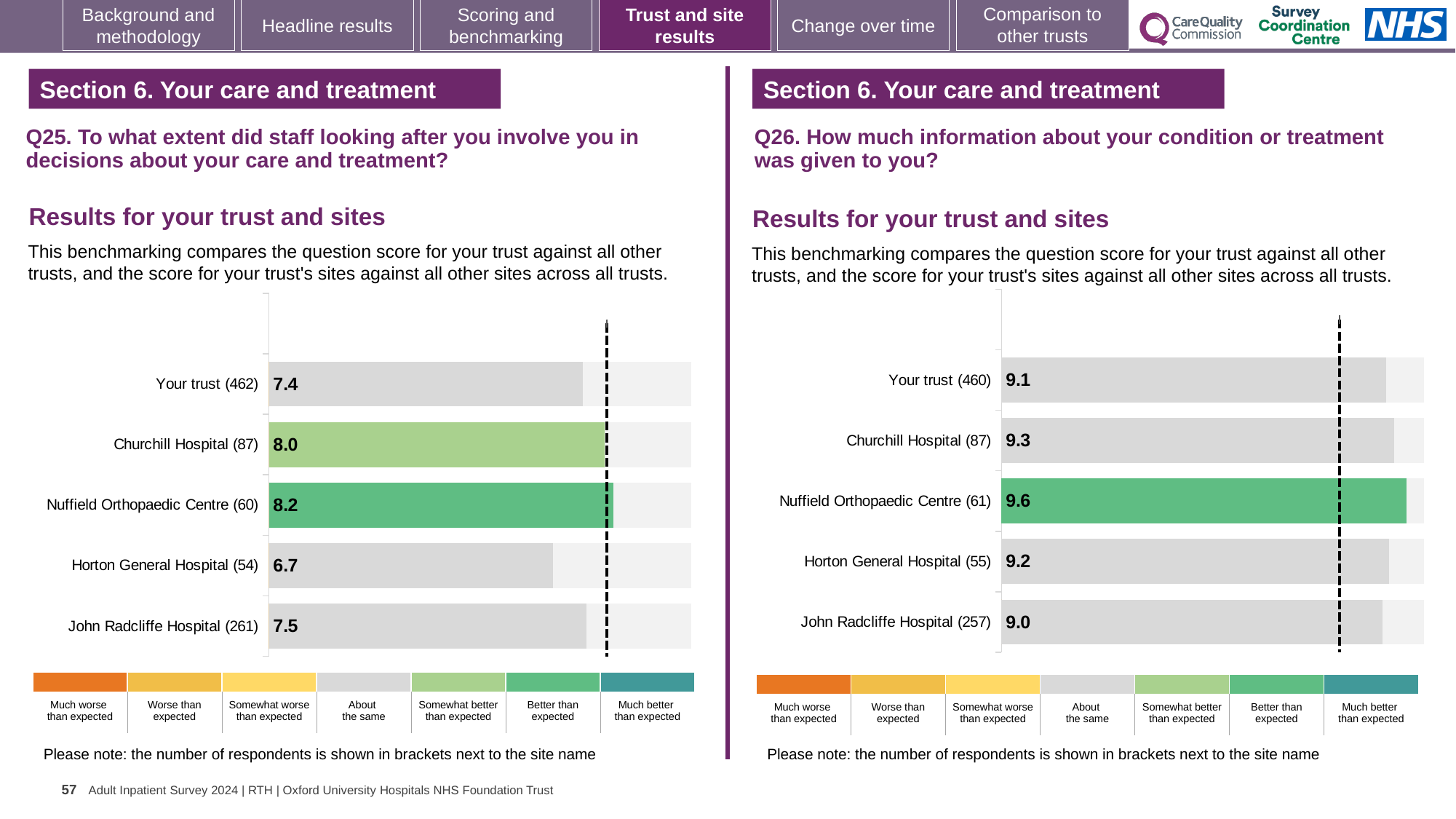
On the Q25 chart (left), what is the difference between the scores for Churchill Hospital and Horton General Hospital? 1.3 On the Q26 chart (right), what is the score for John Radcliffe Hospital? 9.0 On the Q25 chart (left), how many bars are plotted? 5 On the Q26 chart (right), which site has the highest score? Nuffield Orthopaedic Centre On the Q26 chart (right), what is the difference between the scores for Nuffield Orthopaedic Centre and Your trust? 0.5 On the Q25 chart (left), what is the score for Your trust? 7.4 On the Q25 chart (left), which benchmark category does the colour of the Nuffield Orthopaedic Centre bar correspond to in the legend? Better than expected What kind of chart is used on the Q26 chart (right)? Bar chart On the Q25 chart (left), which site has the lowest score? Horton General Hospital On the Q25 chart (left), which site has the highest score? Nuffield Orthopaedic Centre On the Q26 chart (right), which is larger, the score for Churchill Hospital or Horton General Hospital? Churchill Hospital On the Q26 chart (right), how many respondents are shown in brackets for Your trust? 460